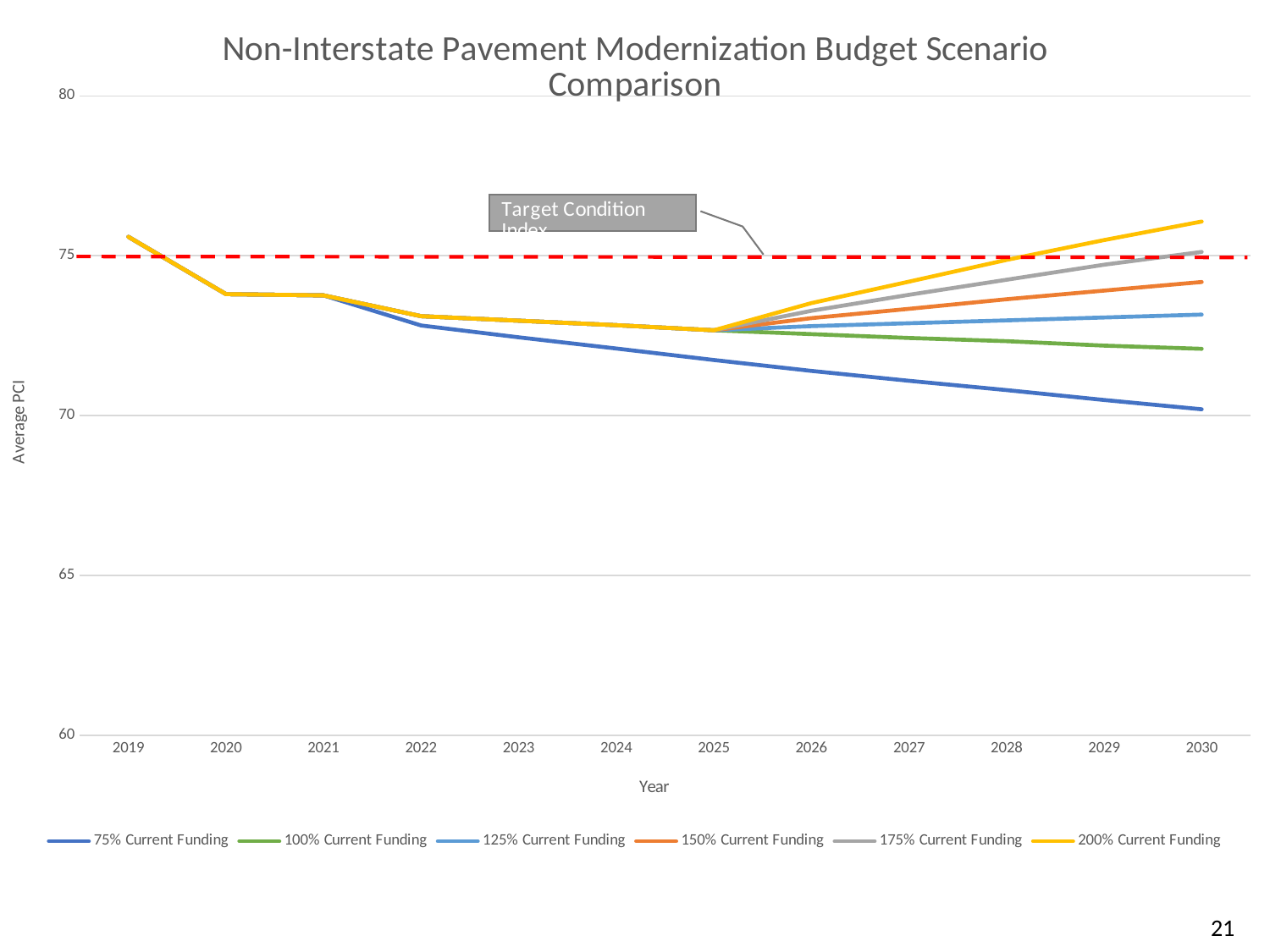
Which funding scenario has the lowest Average PCI in 2030? 75% Current Funding Which funding scenario has the highest Average PCI in 2030? 200% Current Funding How many years are shown along the x axis? 12 What kind of chart is shown on the slide? Line chart What is the label on the vertical axis of the chart? Average PCI Does the 75% Current Funding line rise or fall from 2019 to 2030? Fall How many series does the legend list? 6 Is the Average PCI in 2020 greater or less than 75? less Does the 200% Current Funding line rise or fall from 2025 to 2030? Rise Is the value for 200% Current Funding in 2030 greater or less than 75? greater In 2030, which is larger: the value for 200% Current Funding or the value for 75% Current Funding? 200% Current Funding Is the value for 100% Current Funding in 2030 greater or less than 75? less